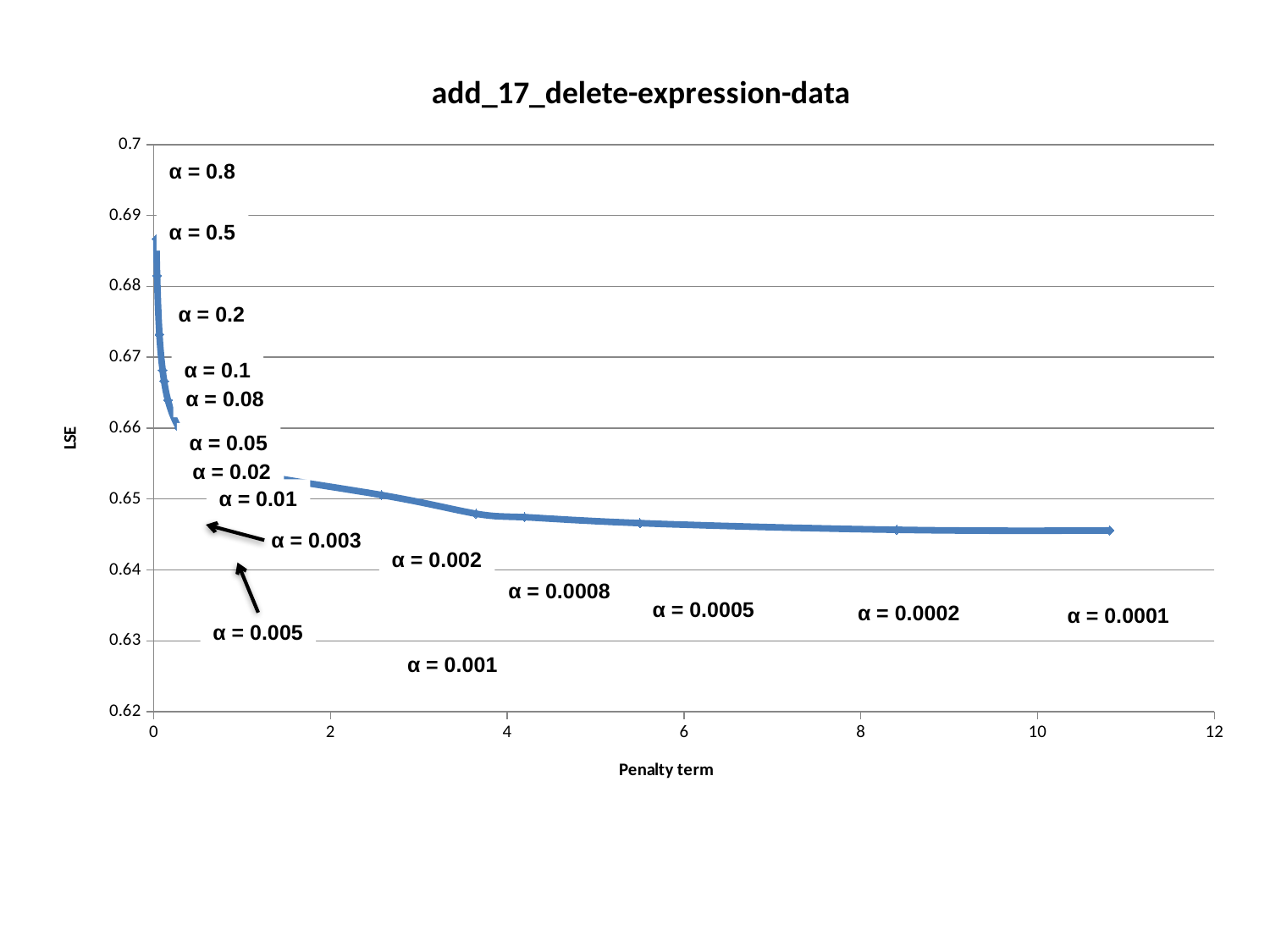
What is the title of the chart? add_17_delete-expression-data What is the label of the x axis? Penalty term Is the LSE value for the point labelled α = 0.8 greater or less than 0.68? greater How many α values are labelled on the chart? 16 Is the LSE value for the point labelled α = 0.0008 greater or less than 0.65? less Which labelled α value has the highest LSE? α = 0.8 As the penalty term increases along the x axis, does LSE rise or fall? fall Is the LSE value for the point labelled α = 0.0001 greater or less than 0.65? less Which has the larger LSE, the point labelled α = 0.8 or the point labelled α = 0.0001? α = 0.8 What kind of chart is shown on the slide? line chart